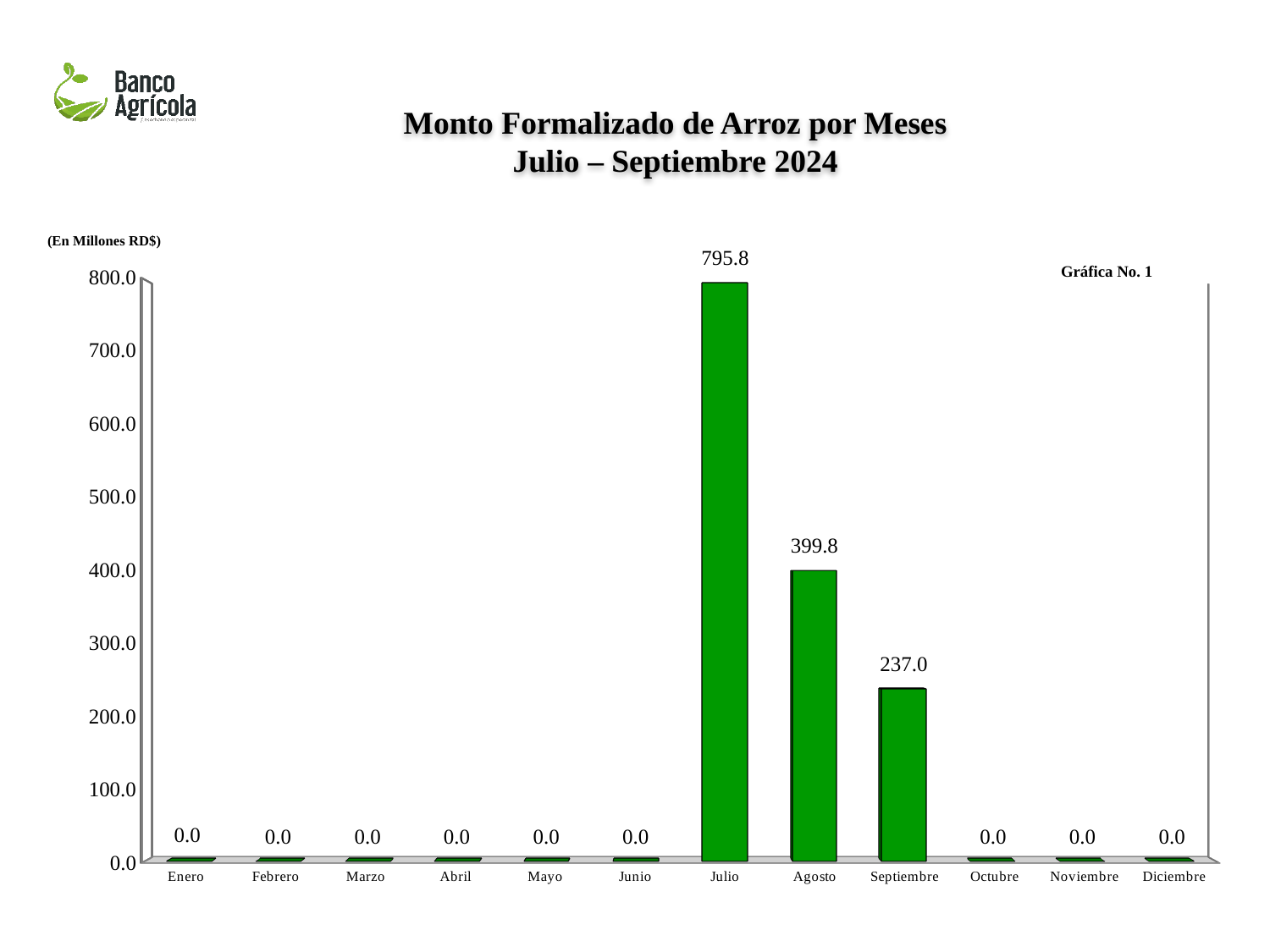
What is the value for Enero? 0.0 What is the value for Septiembre? 237.0 What is the value for Agosto? 399.8 Is the value for Julio greater or less than 700.0? greater What is the value for Julio? 795.8 What is the difference between the values for Agosto and Septiembre? 162.8 What kind of chart is shown on the slide? bar chart What is the difference between the values for Julio and Agosto? 396.0 Which is larger, the value for Agosto or the value for Septiembre? Agosto Which month has the highest value? Julio What unit is stated for the values in the chart? En Millones RD$ How many months are shown on the x axis? 12